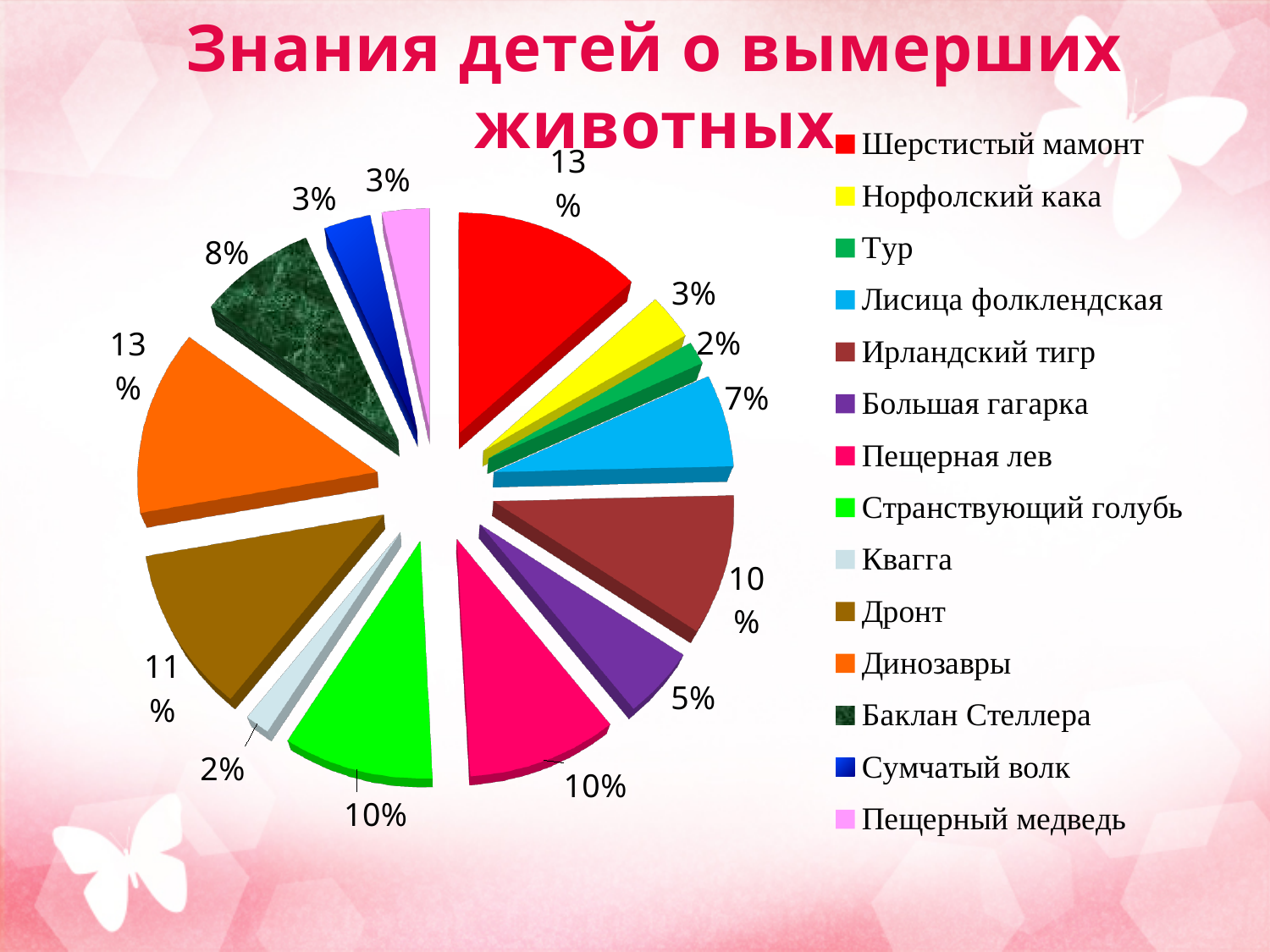
What type of chart is shown on the slide? pie chart What is the value for Большая гагарка? 5% What is the value for Дронт? 11% Which is larger, the value for Ирландский тигр or the value for Лисица фолклендская? Ирландский тигр What is the difference between the values for Дронт and Большая гагарка? 6% Which colour represents Пещерный медведь in the legend? light pink What is the value for Баклан Стеллера? 8% How many categories does the legend list? 14 What share of the pie does Шерстистый мамонт have? 13% What is the title of the chart? Знания детей о вымерших животных What is the value for Лисица фолклендская? 7% What is the value for Динозавры? 13%